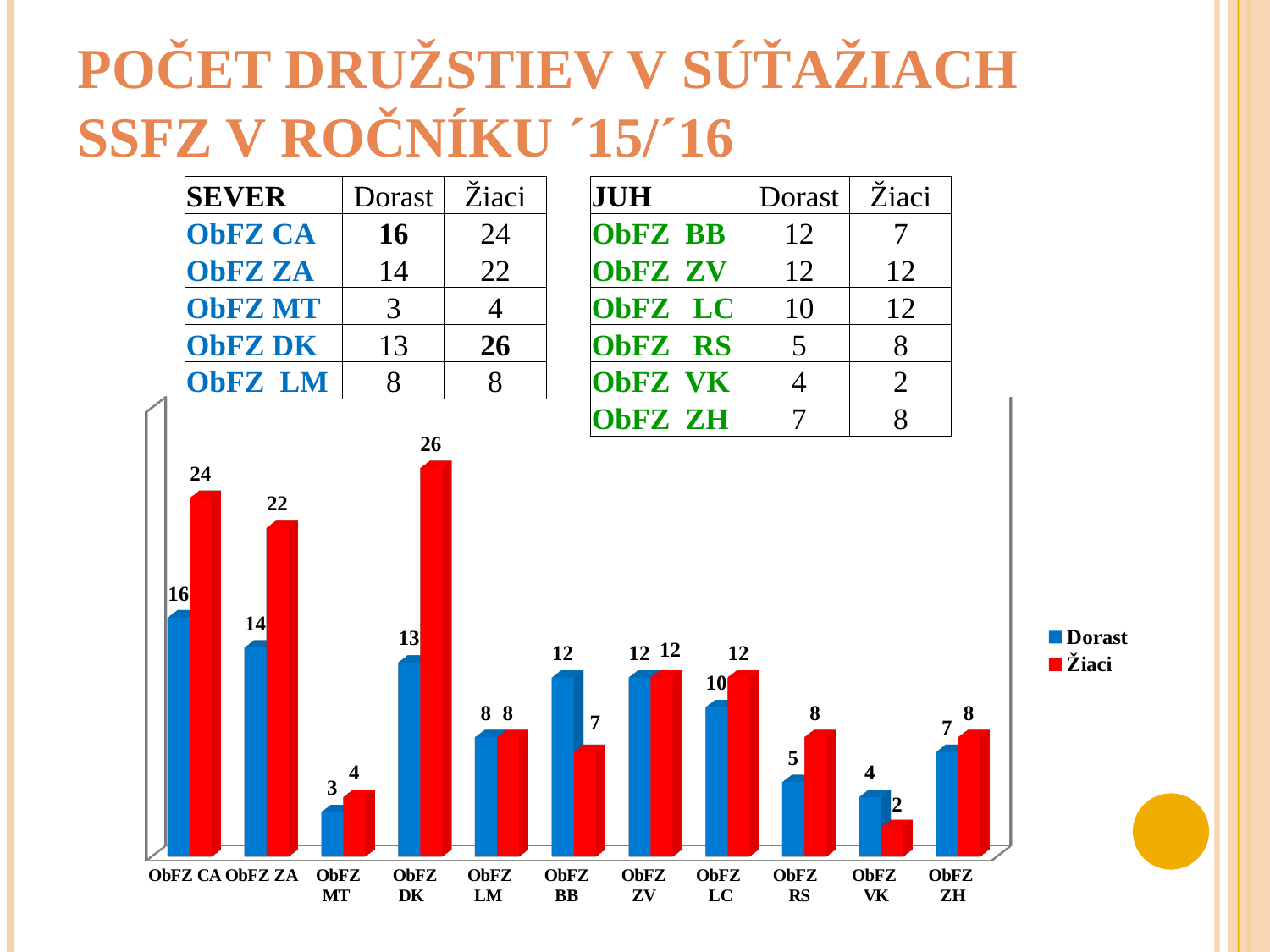
Which colour represents the Žiaci series in the chart? Red How many categories are shown on the x axis of the chart? 11 Which is larger for ObFZ BB, the Dorast value or the Žiaci value? Dorast What kind of chart is shown on the slide? Bar chart Which category has the highest Dorast value? ObFZ CA What is the difference between the Žiaci values for ObFZ DK and ObFZ ZA? 4 How many series does the chart legend list? 2 What is the difference between the Žiaci and Dorast values for ObFZ CA? 8 What is the Žiaci value for ObFZ DK? 26 Which category has the lowest Žiaci value? ObFZ VK What is the Dorast value for ObFZ LC? 10 Which is larger, the Dorast value for ObFZ ZA or the Dorast value for ObFZ DK? ObFZ ZA